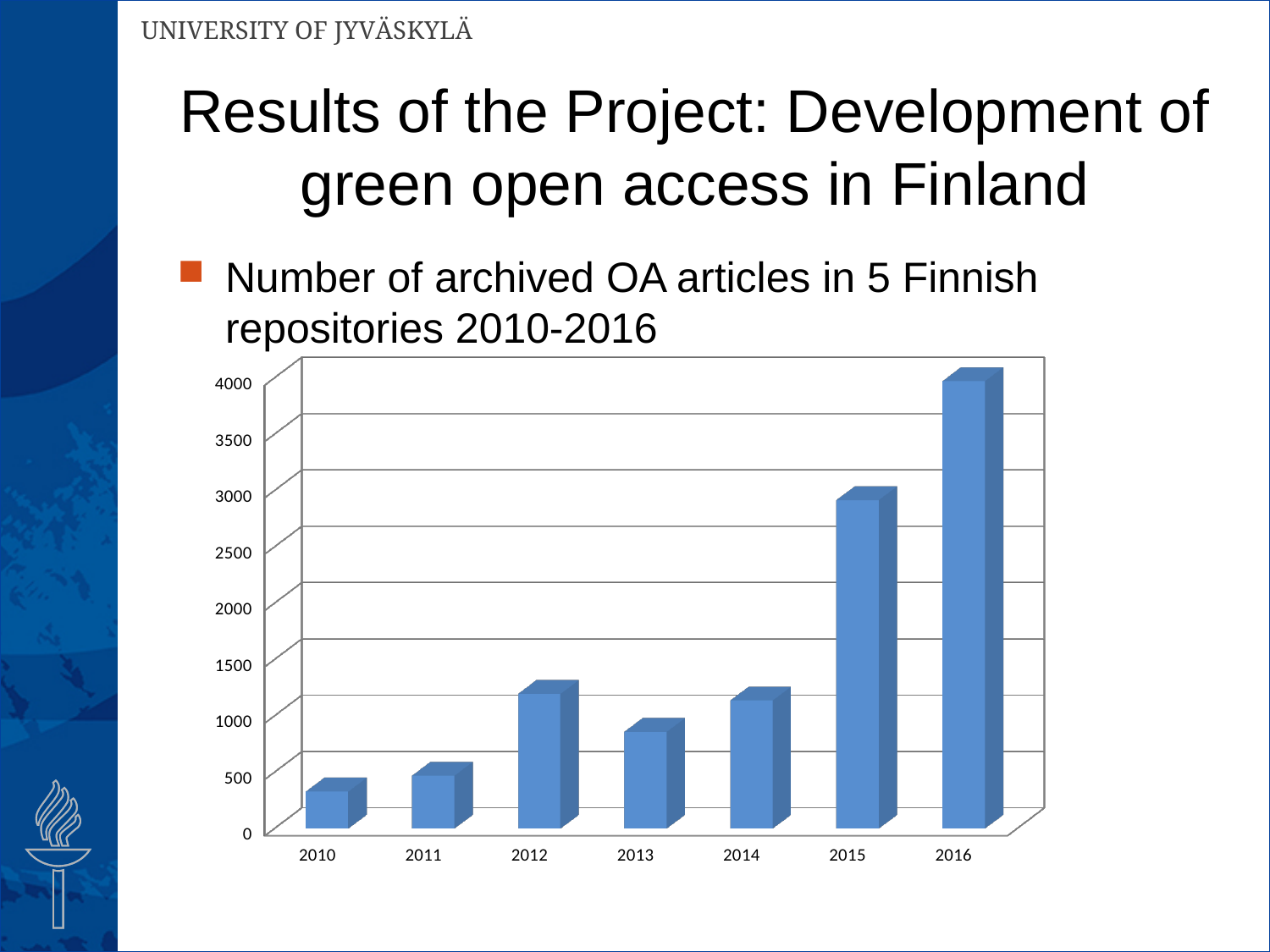
What kind of chart is shown on the slide? bar chart Is the value for 2013 greater or less than 1000? less Which year has the lowest number of archived OA articles? 2010 Do the values generally rise or fall from 2010 to 2016? rise How many years are shown on the x axis of the chart? 7 Is the value for 2015 greater or less than 2500? greater Which year has the larger value, 2012 or 2013? 2012 Which year has the larger value, 2014 or 2015? 2015 Is the value for 2016 greater or less than 3500? greater What is the highest tick value shown on the y axis of the chart? 4000 Which year has the highest number of archived OA articles? 2016